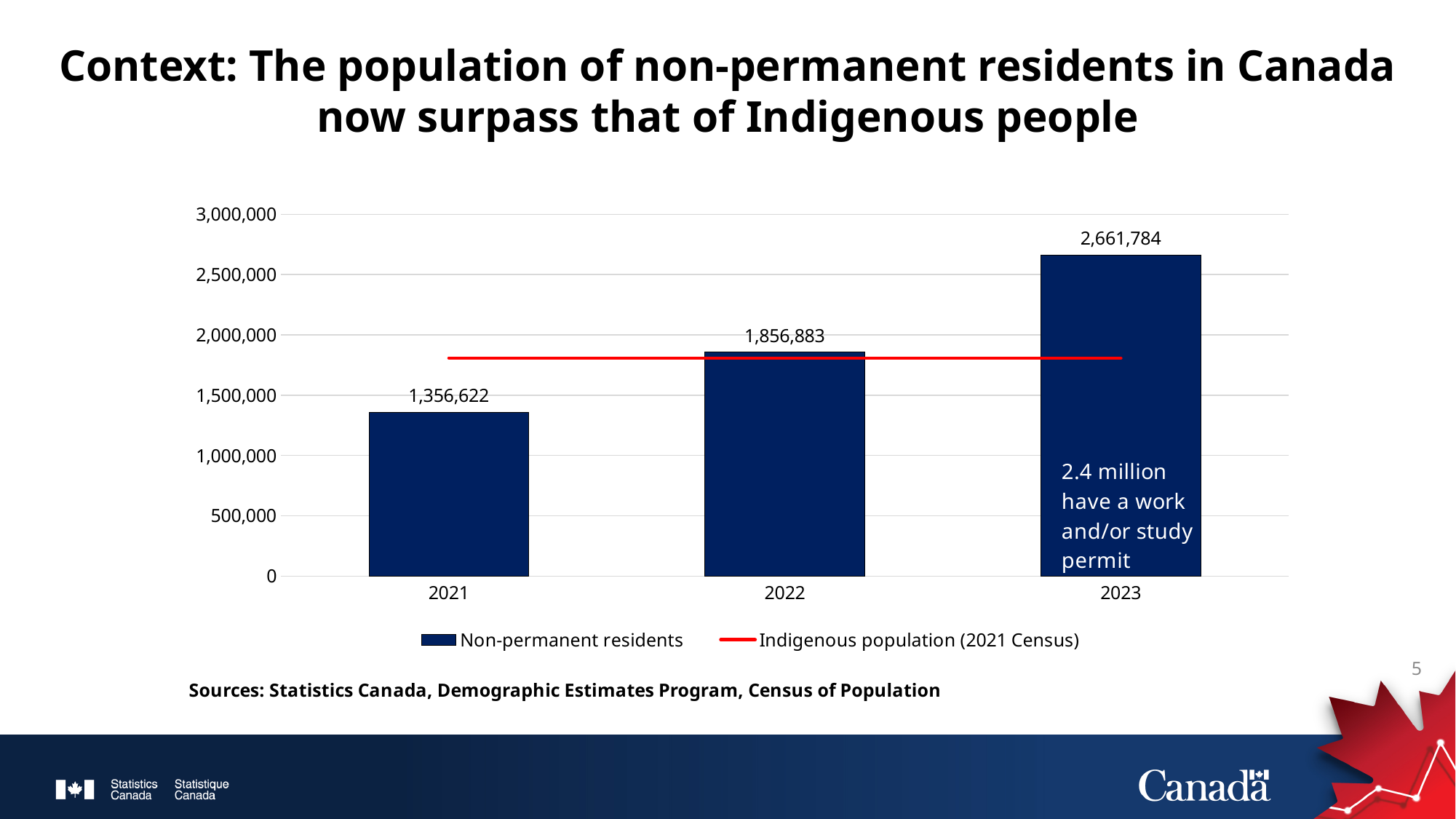
What is the difference between the number of non-permanent residents in 2023 and in 2022? 804,901 Which is larger, the number of non-permanent residents in 2021 or in 2023? 2023 What is the difference between the number of non-permanent residents in 2022 and in 2021? 500,261 Do the non-permanent resident values rise or fall from 2021 to 2023? rise Which year has the lowest number of non-permanent residents? 2021 Is the value of the Indigenous population (2021 Census) line greater or less than 2,000,000? less How many series does the chart legend list? 2 What is the number of non-permanent residents in 2021? 1,356,622 How many years are shown on the x axis of the chart? 3 What is the number of non-permanent residents in 2022? 1,856,883 What is the number of non-permanent residents in 2023? 2,661,784 Which year has the highest number of non-permanent residents? 2023